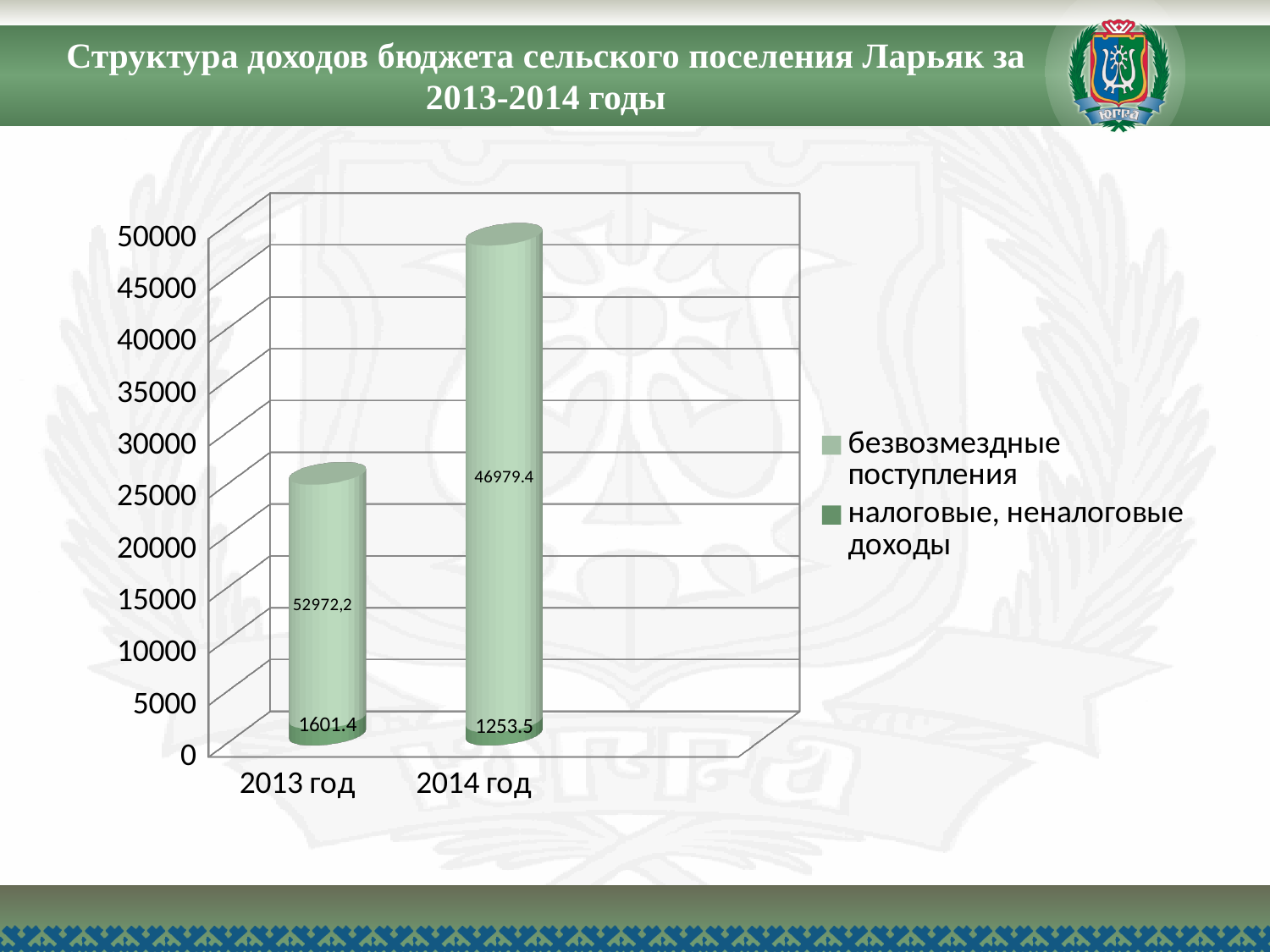
What data label is shown for безвозмездные поступления in 2013 год? 52972,2 How many years (categories) are shown on the x axis? 2 What is the difference between the налоговые, неналоговые доходы values for 2013 год and 2014 год? 347.9 What is the value of налоговые, неналоговые доходы for 2013 год? 1601.4 What is the value of налоговые, неналоговые доходы for 2014 год? 1253.5 Is the total height of the 2014 год bar greater or less than 45000? greater What kind of chart is shown on the slide? Stacked bar chart What is the value of безвозмездные поступления for 2014 год? 46979.4 Is the total height of the 2013 год bar greater or less than 30000? less Does the value of налоговые, неналоговые доходы rise or fall from 2013 год to 2014 год? Fall How many series does the legend list? 2 Which year has the higher value for налоговые, неналоговые доходы? 2013 год